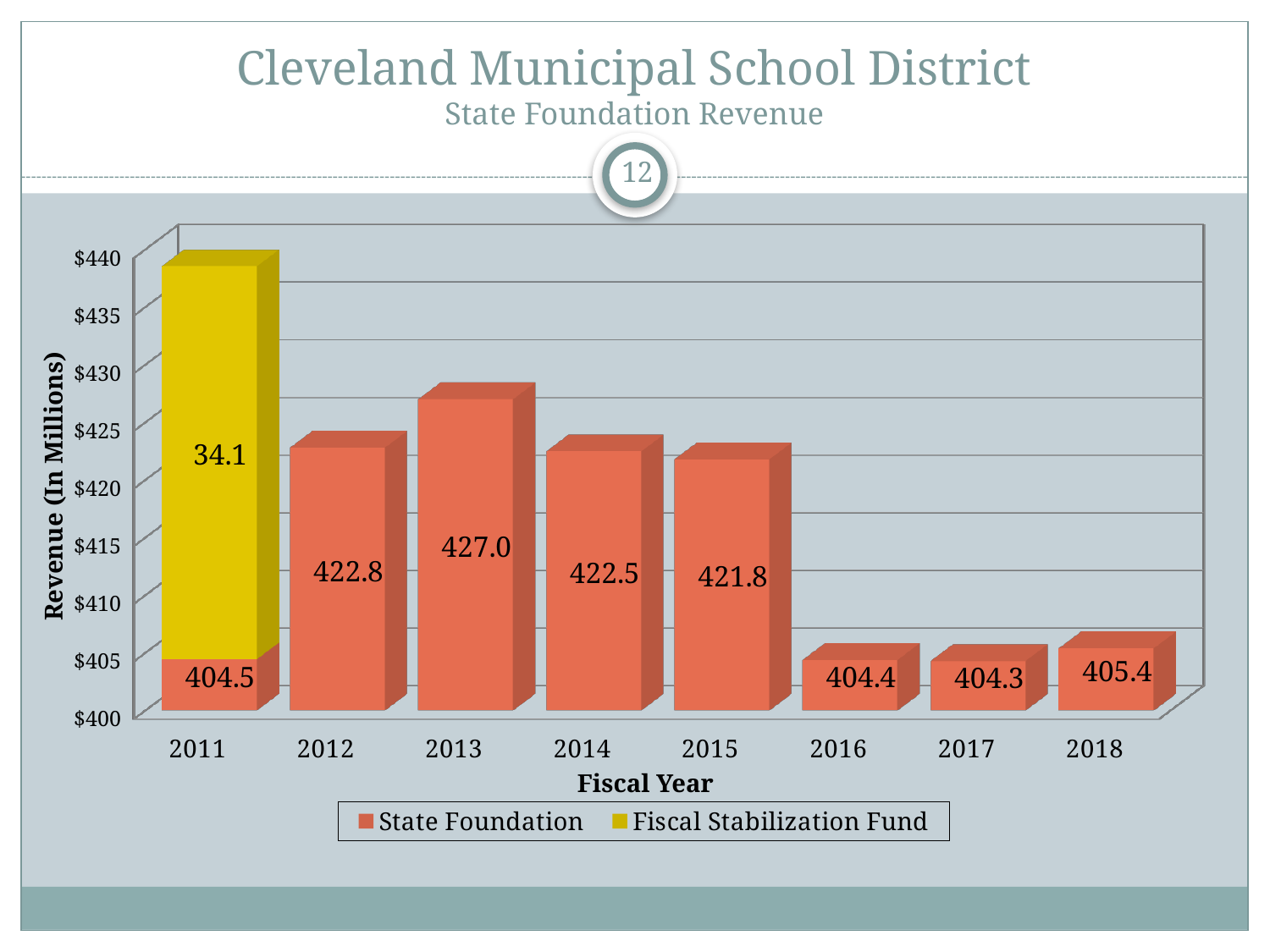
What kind of chart is shown on the slide? Bar chart Which series is shown in yellow in the legend? Fiscal Stabilization Fund What is the total of the stacked bar for 2011 (State Foundation plus Fiscal Stabilization Fund)? 438.6 Which fiscal year has the lowest State Foundation revenue? 2017 How many series does the legend list? 2 What is the Fiscal Stabilization Fund value shown for 2011? 34.1 Which is larger, the State Foundation revenue in 2014 or in 2015? 2014 How many fiscal years are shown on the x axis? 8 What is the State Foundation revenue for fiscal year 2013? 427.0 What is the difference between the State Foundation revenue in 2013 and in 2012? 4.2 Which fiscal year has the highest State Foundation revenue? 2013 What is the State Foundation revenue for fiscal year 2017? 404.3